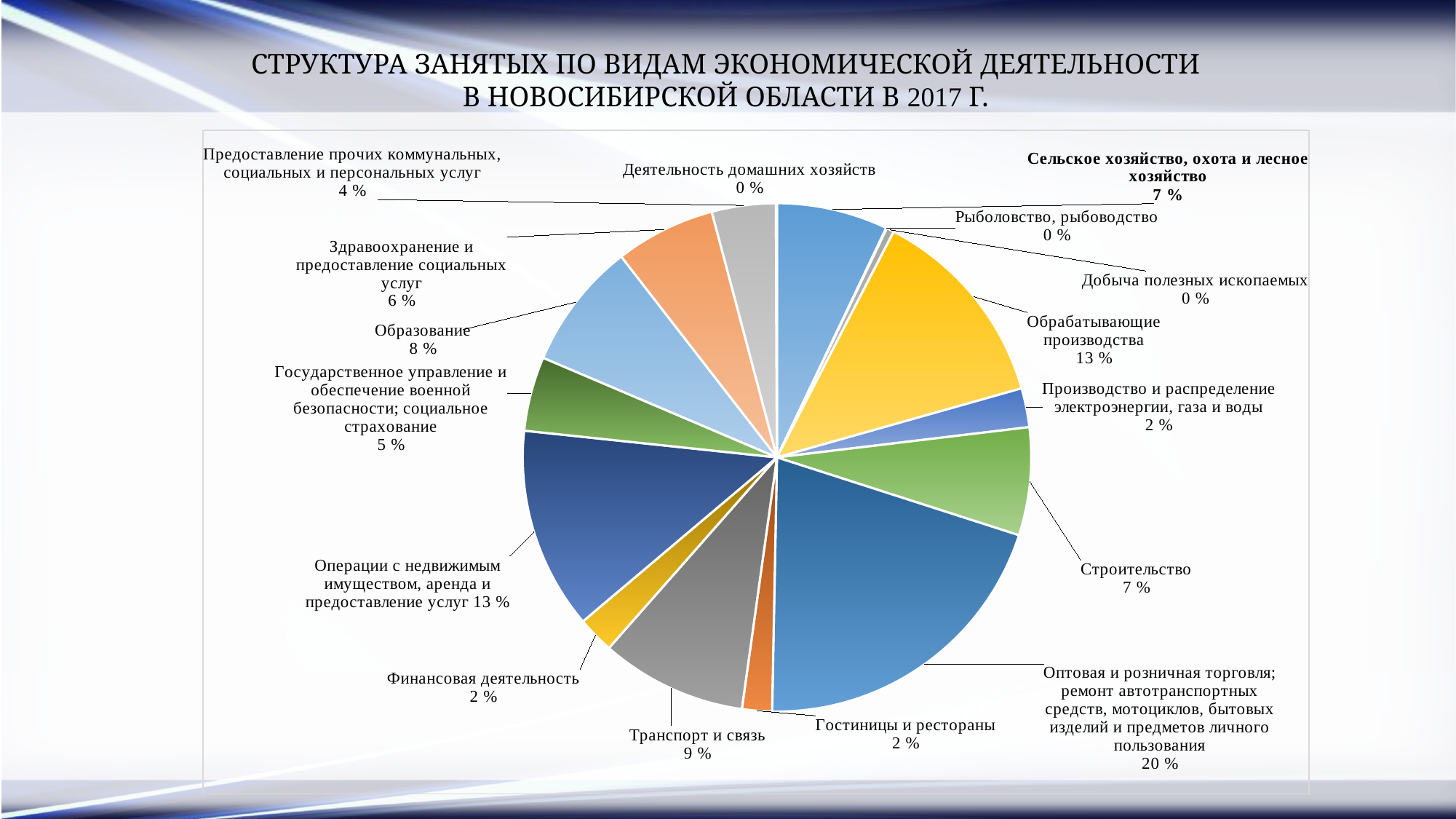
Which has a larger share: "Здравоохранение и предоставление социальных услуг" or "Государственное управление и обеспечение военной безопасности; социальное страхование"? Здравоохранение и предоставление социальных услуг What percentage is shown for "Транспорт и связь"? 9 % How many categories of economic activity are shown in the pie chart? 16 What percentage is shown for "Строительство"? 7 % What year does the chart title refer to? 2017 Which has a larger share: "Транспорт и связь" or "Образование"? Транспорт и связь What percentage is shown for "Обрабатывающие производства"? 13 % What kind of chart is shown on the slide? Pie chart What is the difference in percentage points between "Оптовая и розничная торговля" and "Обрабатывающие производства"? 7 What percentage is shown for "Образование"? 8 % Which type of economic activity has the largest share of employed people? Оптовая и розничная торговля; ремонт автотранспортных средств, мотоциклов, бытовых изделий и предметов личного пользования What share of employed people is in "Оптовая и розничная торговля; ремонт автотранспортных средств, мотоциклов, бытовых изделий и предметов личного пользования"? 20 %